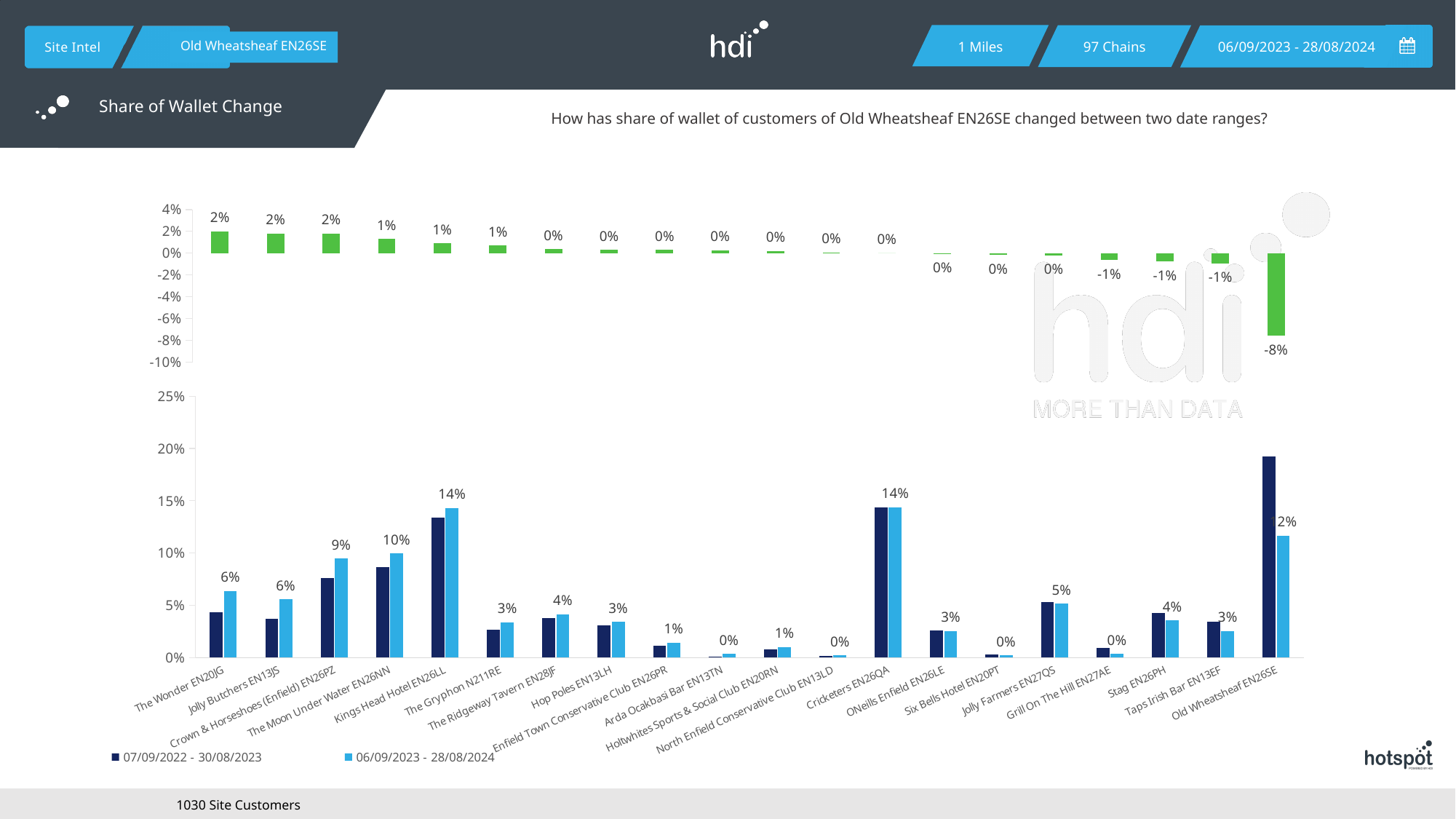
In the bottom chart, what is the 06/09/2023 - 28/08/2024 value for Old Wheatsheaf EN26SE? 12% In the top chart (share of wallet change), what is the value for The Wonder EN20JG? 2% In the top chart (share of wallet change), what is the value for Stag EN26PH? -1% How many categories are shown on the x axis of the bottom chart? 20 In the bottom chart, what is the 06/09/2023 - 28/08/2024 value for Jolly Farmers EN27QS? 5% In the bottom chart, is the 07/09/2022 - 30/08/2023 value for Old Wheatsheaf EN26SE greater or less than 15%? greater In the bottom chart, what is the 06/09/2023 - 28/08/2024 value for Kings Head Hotel EN26LL? 14% In the top chart (share of wallet change), what is the value for Old Wheatsheaf EN26SE? -8% In the bottom chart, what is the difference between the 06/09/2023 - 28/08/2024 values for Kings Head Hotel EN26LL and The Gryphon N211RE? 11% How many series does the legend of the bottom chart list? 2 In the top chart (share of wallet change), which category has the lowest value? Old Wheatsheaf EN26SE In the bottom chart, which is larger for 06/09/2023 - 28/08/2024: Crown & Horseshoes (Enfield) EN26PZ or Jolly Butchers EN13JS? Crown & Horseshoes (Enfield) EN26PZ